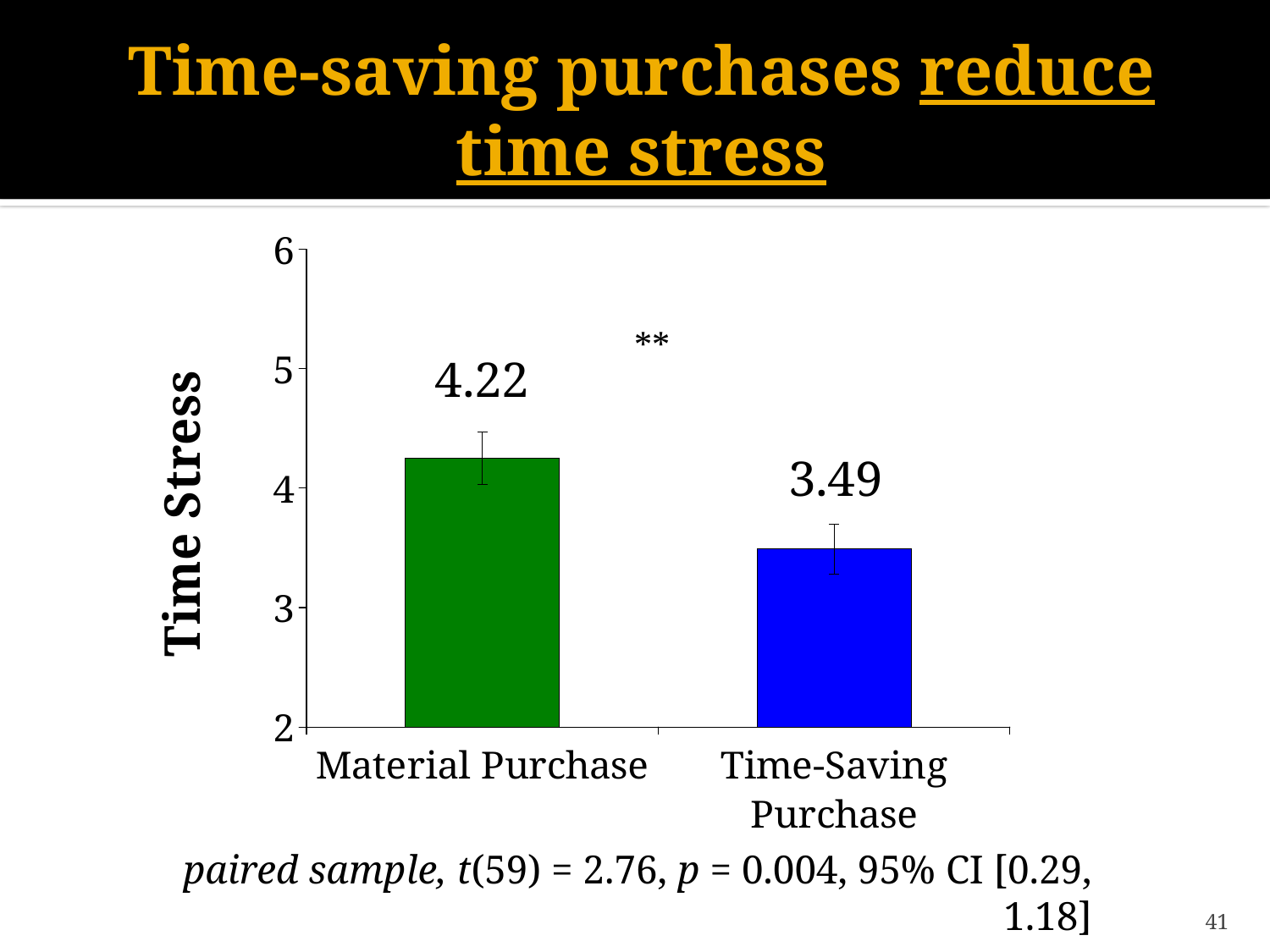
Which category has the higher Time Stress value? Material Purchase What colour is the bar for Time-Saving Purchase? blue What kind of chart is shown on the slide? bar chart What is the Time Stress value for Time-Saving Purchase? 3.49 Is the Time Stress value for Time-Saving Purchase greater or less than 4? less Do the values rise or fall from Material Purchase to Time-Saving Purchase? fall What is the label of the y axis? Time Stress What is the Time Stress value for Material Purchase? 4.22 What is the difference in Time Stress between Material Purchase and Time-Saving Purchase? 0.73 Is the Time Stress value for Material Purchase greater or less than 4? greater How many categories are shown on the chart? 2 Which category has the lower Time Stress value? Time-Saving Purchase